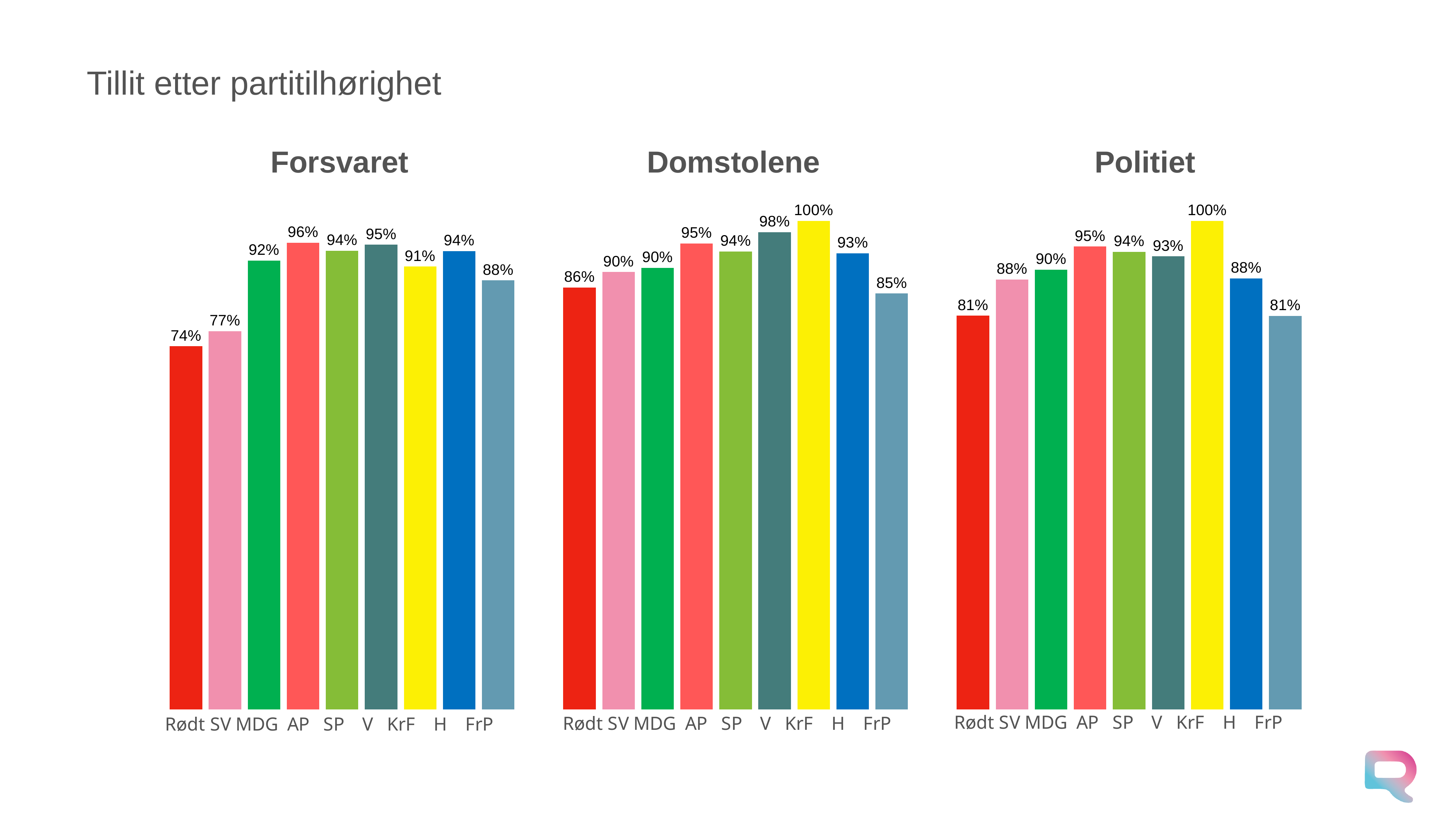
In the Forsvaret chart, what is the value for Rødt? 74% In the Politiet chart, which party has the highest value? KrF In the Domstolene chart, what is the difference between the values for KrF and Rødt? 14% In the Forsvaret chart, which party has the highest value? AP In the Forsvaret chart, which party has the lowest value? Rødt What kind of chart is the Domstolene chart? Bar chart What is the title of the slide? Tillit etter partitilhørighet In the Politiet chart, what is the value for H? 88% In the Domstolene chart, which party has the lowest value? FrP How many parties are shown in the Forsvaret chart? 9 In the Politiet chart, which is larger, the value for AP or the value for V? AP In the Domstolene chart, what is the value for KrF? 100%